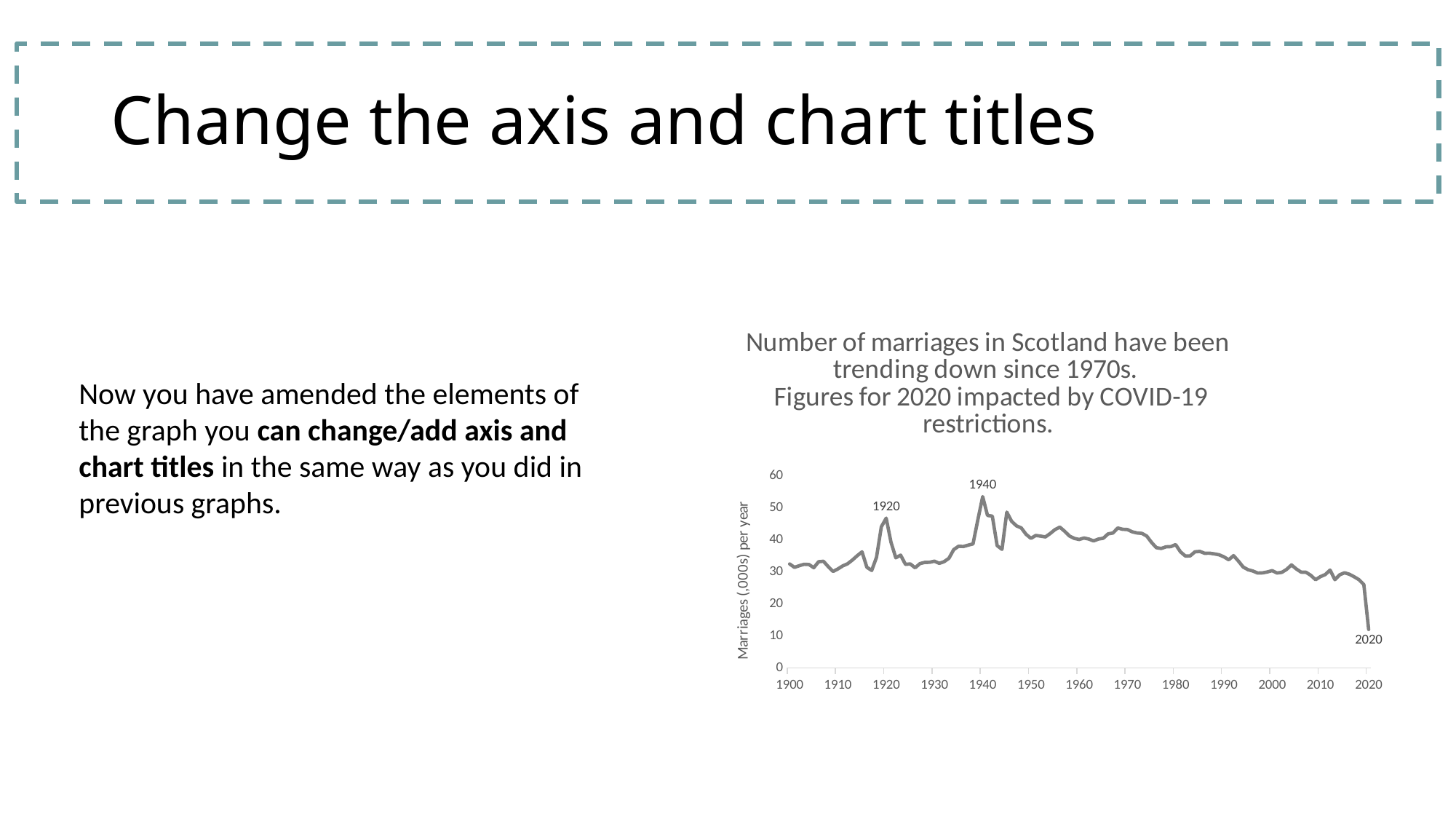
Does the number of marriages rise or fall from 1970 to 2020? fall In which labelled year does the line reach its lowest point? 2020 What is the title of the chart? Number of marriages in Scotland have been trending down since 1970s. Figures for 2020 impacted by COVID-19 restrictions. What is the label on the vertical axis of the chart? Marriages (,000s) per year In which labelled year does the line reach its highest point? 1940 Which year has the higher value, 1920 or 1940? 1940 How many lines (series) are plotted on the chart? 1 What kind of chart is shown on the slide? line chart Is the value for 1920 greater or less than 40? greater Which year has the higher value, 1900 or 2020? 1900 Is the value for 1940 greater or less than 50? greater Is the value for 2020 greater or less than 20? less